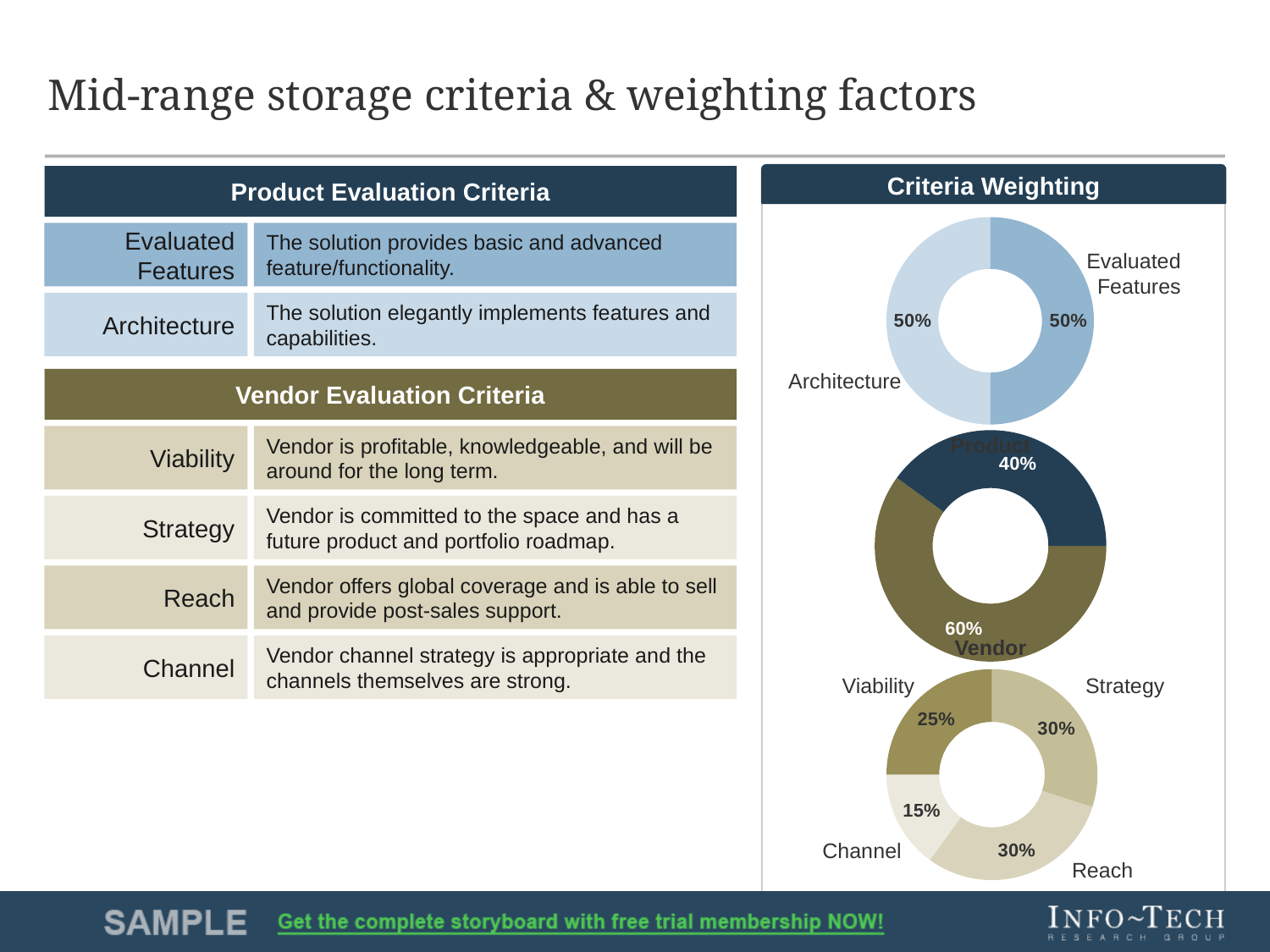
In the middle donut chart under Criteria Weighting, what is the value for Vendor? 60% In the bottom donut chart under Criteria Weighting, what is the value for Viability? 25% In the top donut chart under Criteria Weighting, what is the value for Evaluated Features? 50% In the bottom donut chart under Criteria Weighting, what is the difference between the Viability and Channel values? 10% In the middle donut chart under Criteria Weighting, what is the difference between the Vendor and Product values? 20% In the bottom donut chart under Criteria Weighting, what is the value for Channel? 15% In the bottom donut chart under Criteria Weighting, which category has the lowest value? Channel In the middle donut chart under Criteria Weighting, which is larger, Product or Vendor? Vendor In the top donut chart under Criteria Weighting, what is the value for Architecture? 50% In the bottom donut chart under Criteria Weighting, how many categories are shown? 4 In the middle donut chart under Criteria Weighting, what is the value for Product? 40% What kind of chart is used for the Criteria Weighting visuals? Donut (pie) chart